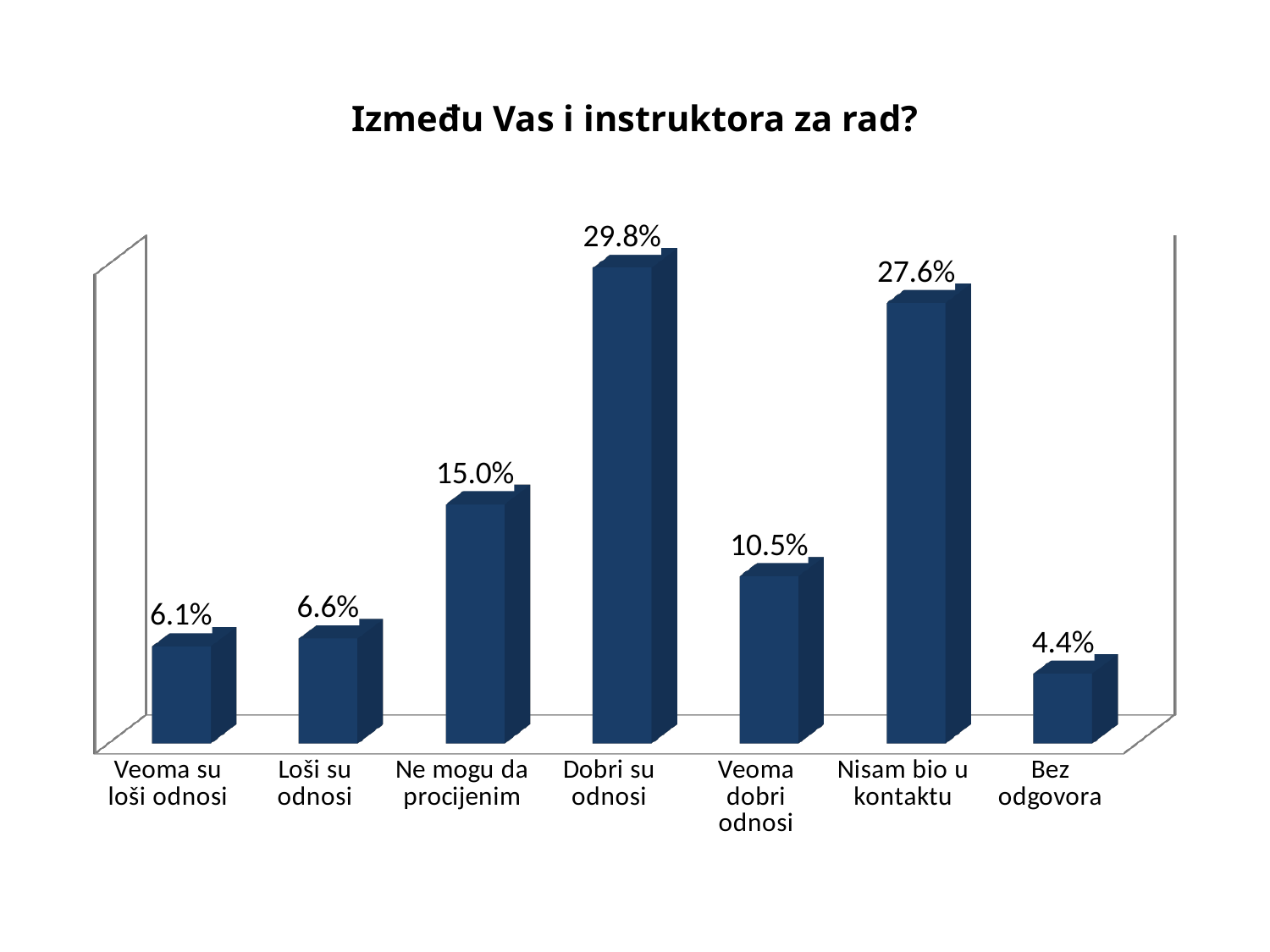
What is the title of the chart? Između Vas i instruktora za rad? What kind of chart is shown on the slide? Bar chart Which category has the lowest value? Bez odgovora What is the value for "Bez odgovora"? 4.4% Which category has the highest value? Dobri su odnosi What is the difference between "Ne mogu da procijenim" and "Veoma dobri odnosi"? 4.5% Which is larger, "Veoma su loši odnosi" or "Loši su odnosi"? Loši su odnosi What is the difference between "Dobri su odnosi" and "Nisam bio u kontaktu"? 2.2% What is the value for "Ne mogu da procijenim"? 15.0% What is the value for "Dobri su odnosi"? 29.8% What is the value for "Nisam bio u kontaktu"? 27.6% How many categories are shown on the chart? 7